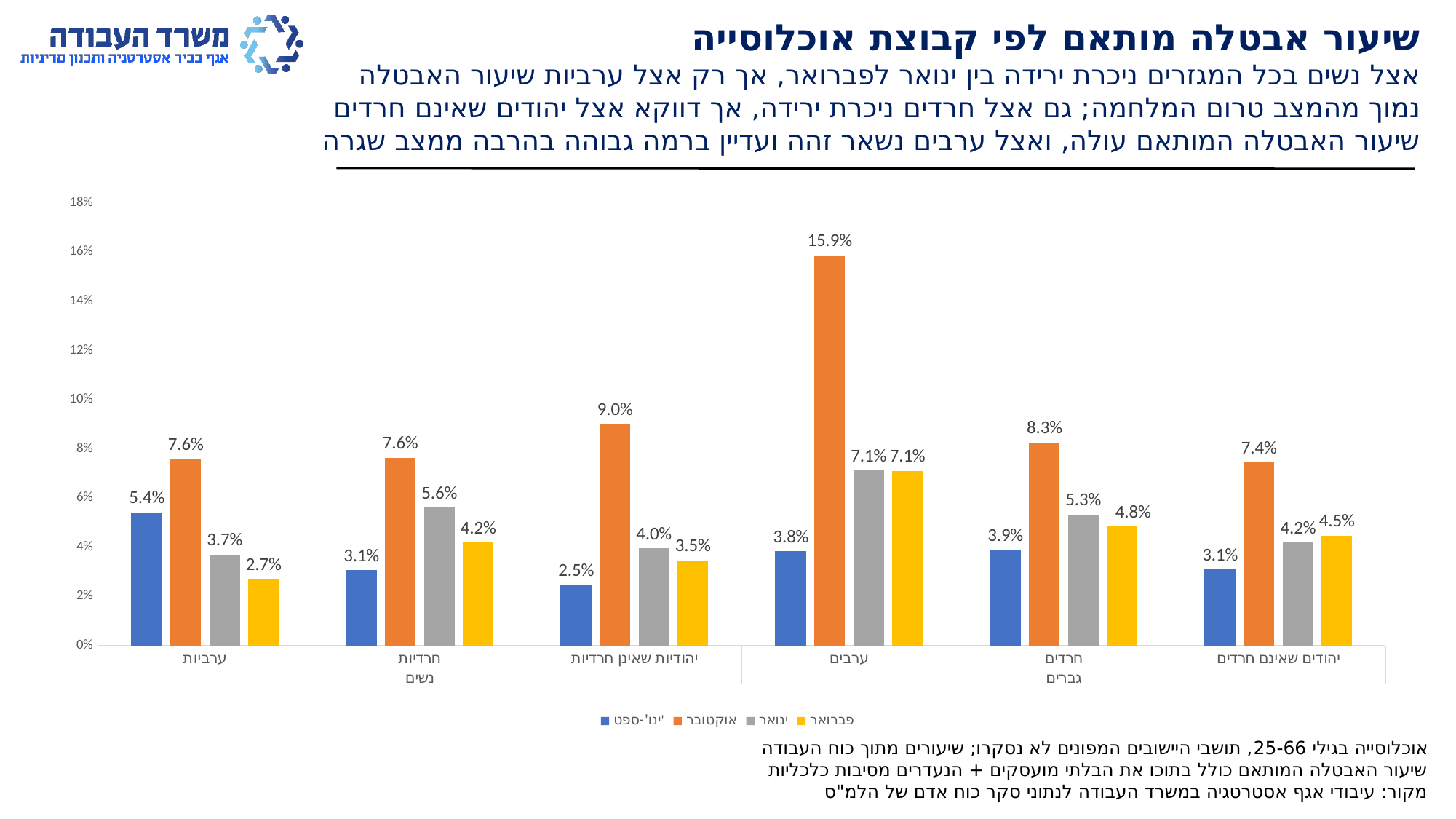
How many population groups (categories) are shown on the x axis? 6 Is the אוקטובר value for ערבים greater or less than 14%? greater What type of chart is shown on the slide? bar chart How many series does the legend list? 4 What is the value for ערביות in the פברואר series? 2.7% What is the difference between the אוקטובר and פברואר values for ערבים? 8.8% Which is larger for יהודים שאינם חרדים: the ינואר value or the פברואר value? פברואר What is the value for ערבים in the אוקטובר series? 15.9% Which series is shown in orange in the legend? אוקטובר What is the value for חרדיות in the ינואר series? 5.6% Which category has the highest value in the אוקטובר series? ערבים Which category has the lowest value in the יוני-ספט series? יהודיות שאינן חרדיות